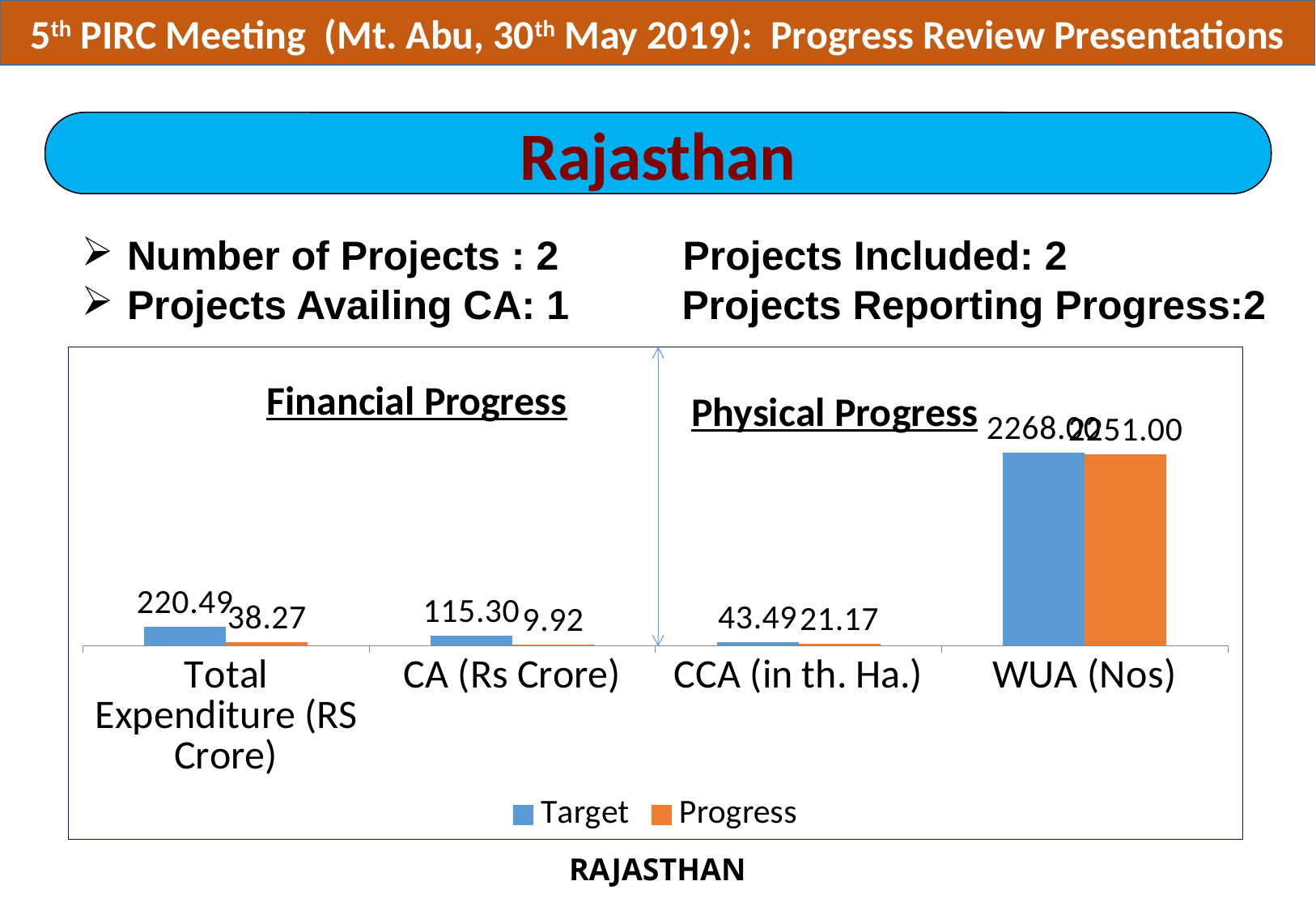
Which category has the highest Target value? WUA (Nos) What is the difference between the Target and Progress values for Total Expenditure (RS Crore)? 182.22 What is the Target value for CA (Rs Crore)? 115.30 What is the difference between the Target and Progress values for CCA (in th. Ha.)? 22.32 What is the Target value for CCA (in th. Ha.)? 43.49 What is the Target value for Total Expenditure (RS Crore)? 220.49 For CA (Rs Crore), which is larger, the Target or the Progress value? Target What is the Progress value for CA (Rs Crore)? 9.92 How many series does the chart legend list? 2 What is the Progress value for Total Expenditure (RS Crore)? 38.27 What is the Progress value for WUA (Nos)? 2251.00 How many categories are shown on the x axis of the chart? 4